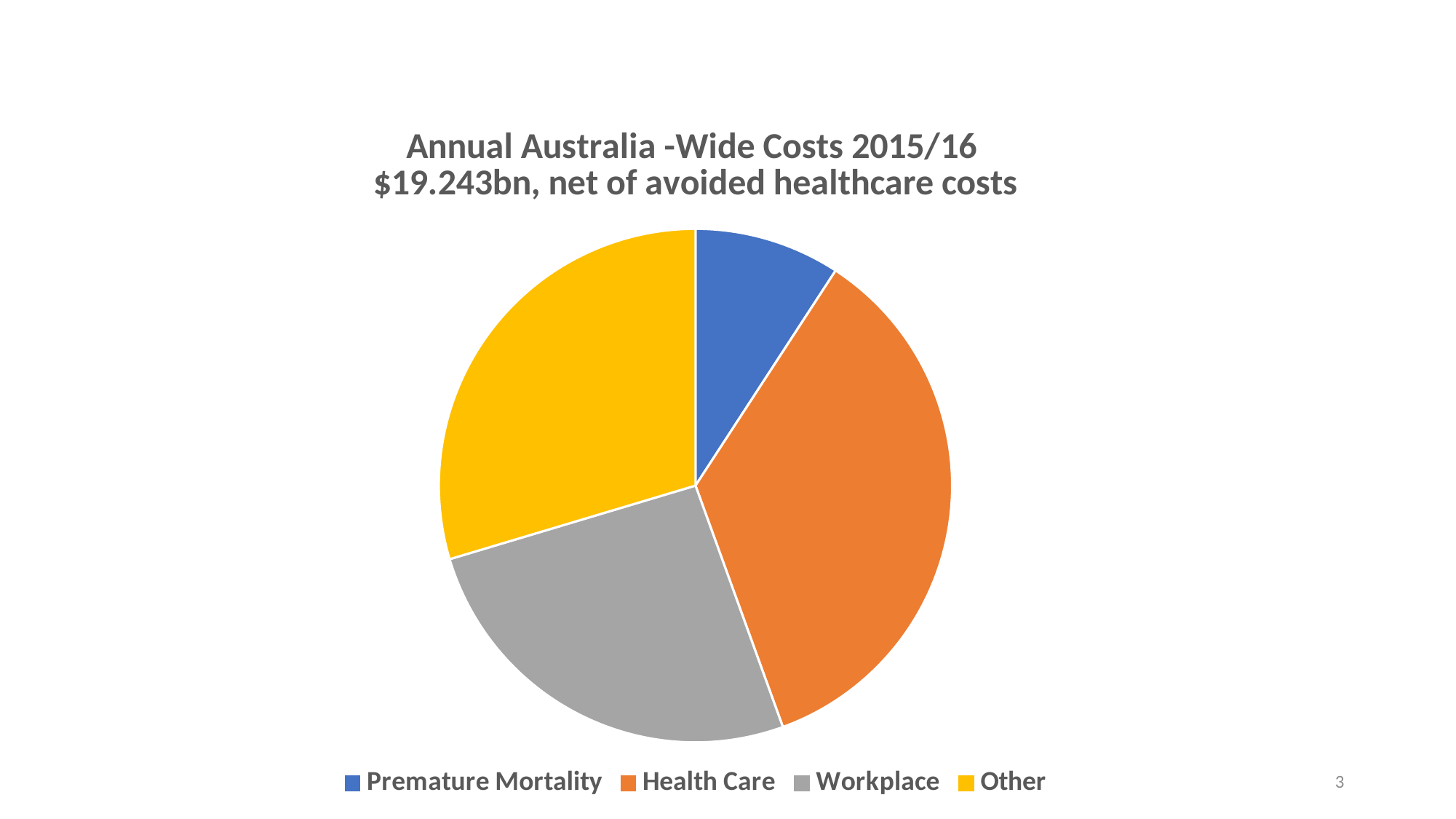
Which slice is larger, Health Care or Premature Mortality? Health Care What total cost figure is stated in the chart title? $19.243bn How many slices does the pie chart have? 4 How many entries does the legend list? 4 Which category has the smallest slice of the pie? Premature Mortality Which slice is larger, Workplace or Premature Mortality? Workplace Which category is shown in yellow in the pie chart? Other Which slice is larger, Other or Premature Mortality? Other Which category has the largest slice of the pie? Health Care What kind of chart is shown on the slide? pie chart